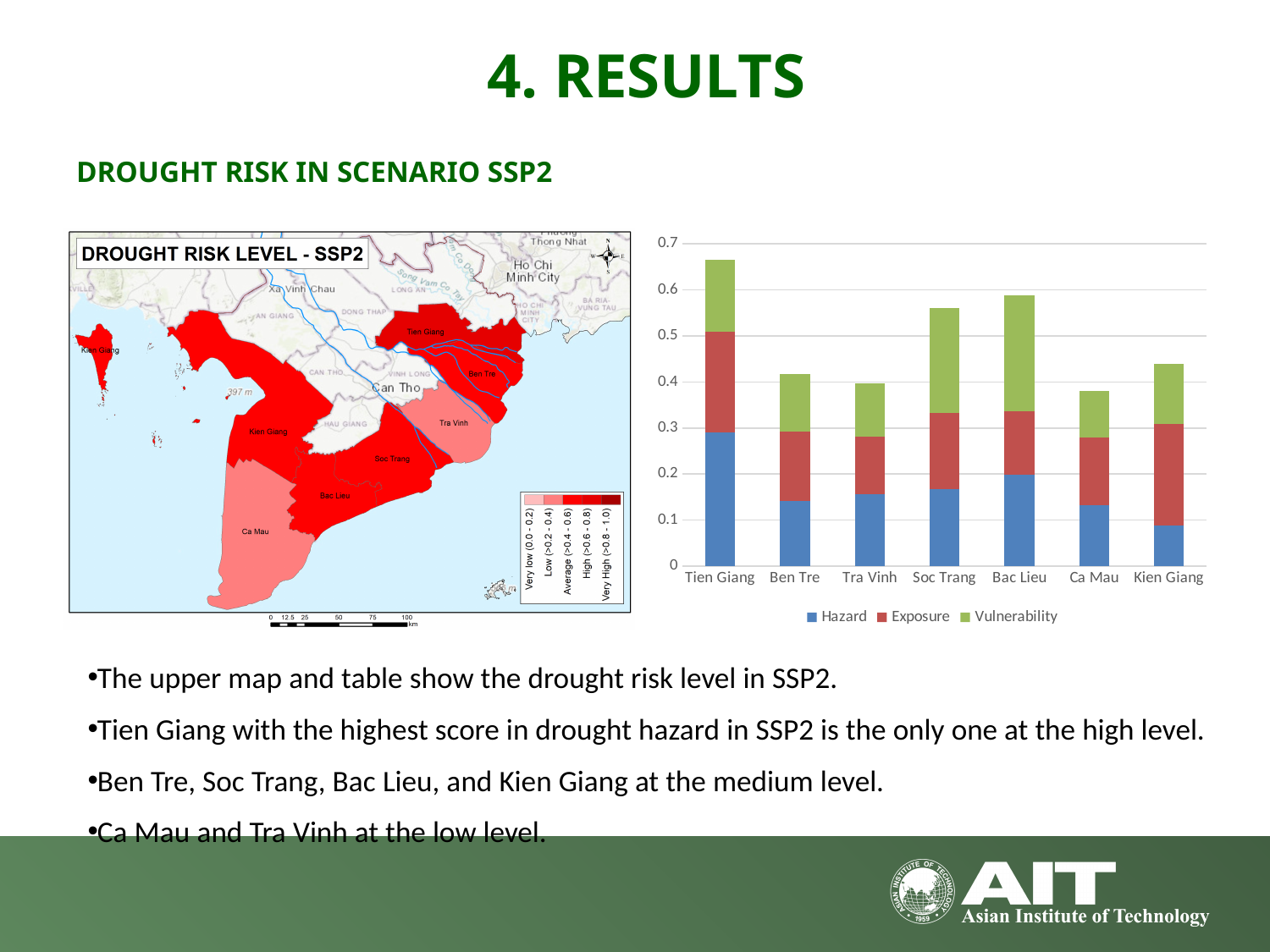
Which series in the bar chart is shown in green? Vulnerability Is the total stacked value for Tien Giang greater or less than 0.6? greater Which has the larger total stacked bar, Soc Trang or Kien Giang? Soc Trang Is the total stacked value for Soc Trang greater or less than 0.5? greater Is the total stacked value for Ca Mau greater or less than 0.4? less Which province has the highest Hazard value in the bar chart? Tien Giang How many series does the legend of the bar chart list? 3 Which province has the highest total stacked bar in the chart? Tien Giang How many provinces are shown on the x axis of the bar chart? 7 Which has the larger total stacked bar, Bac Lieu or Ben Tre? Bac Lieu What kind of chart is shown on the right side of the slide? Stacked bar chart Which province has the lowest Hazard value in the bar chart? Kien Giang